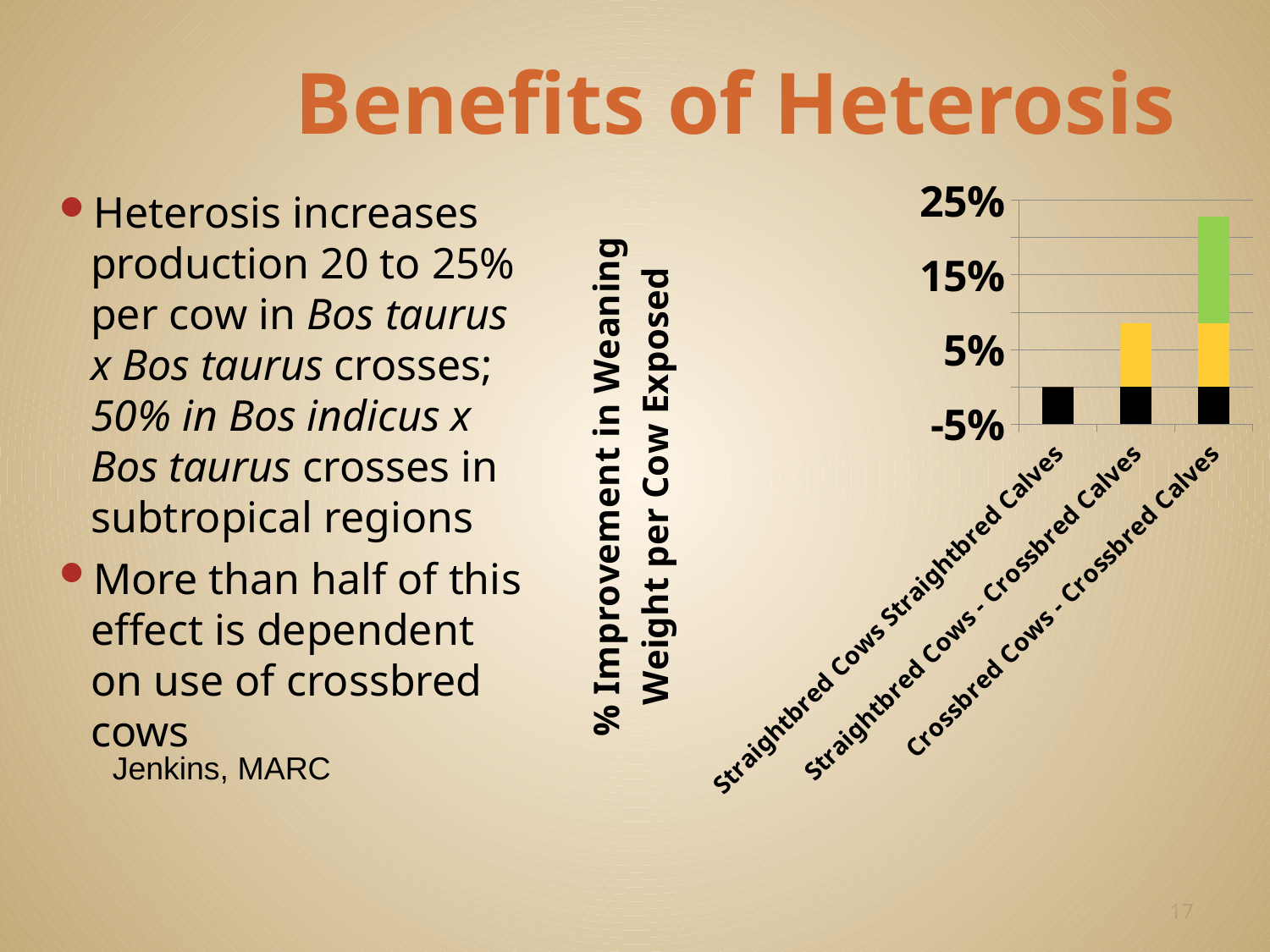
Which category has the tallest bar in the chart? Crossbred Cows - Crossbred Calves Is the top of the bar for Straightbred Cows Straightbred Calves greater or less than 5%? less Which category has the shortest bar in the chart? Straightbred Cows Straightbred Calves Is the top of the bar for Crossbred Cows - Crossbred Calves greater or less than 15%? greater Which category's bar includes a green segment? Crossbred Cows - Crossbred Calves What is the title of the chart's vertical axis? % Improvement in Weaning Weight per Cow Exposed Is the top of the bar for Straightbred Cows - Crossbred Calves greater or less than 15%? less How many categories are shown on the x axis of the chart? 3 Which bar is taller: Straightbred Cows - Crossbred Calves or Crossbred Cows - Crossbred Calves? Crossbred Cows - Crossbred Calves What kind of chart is shown on the slide? bar chart Do the bar heights rise or fall from left to right across the chart? rise